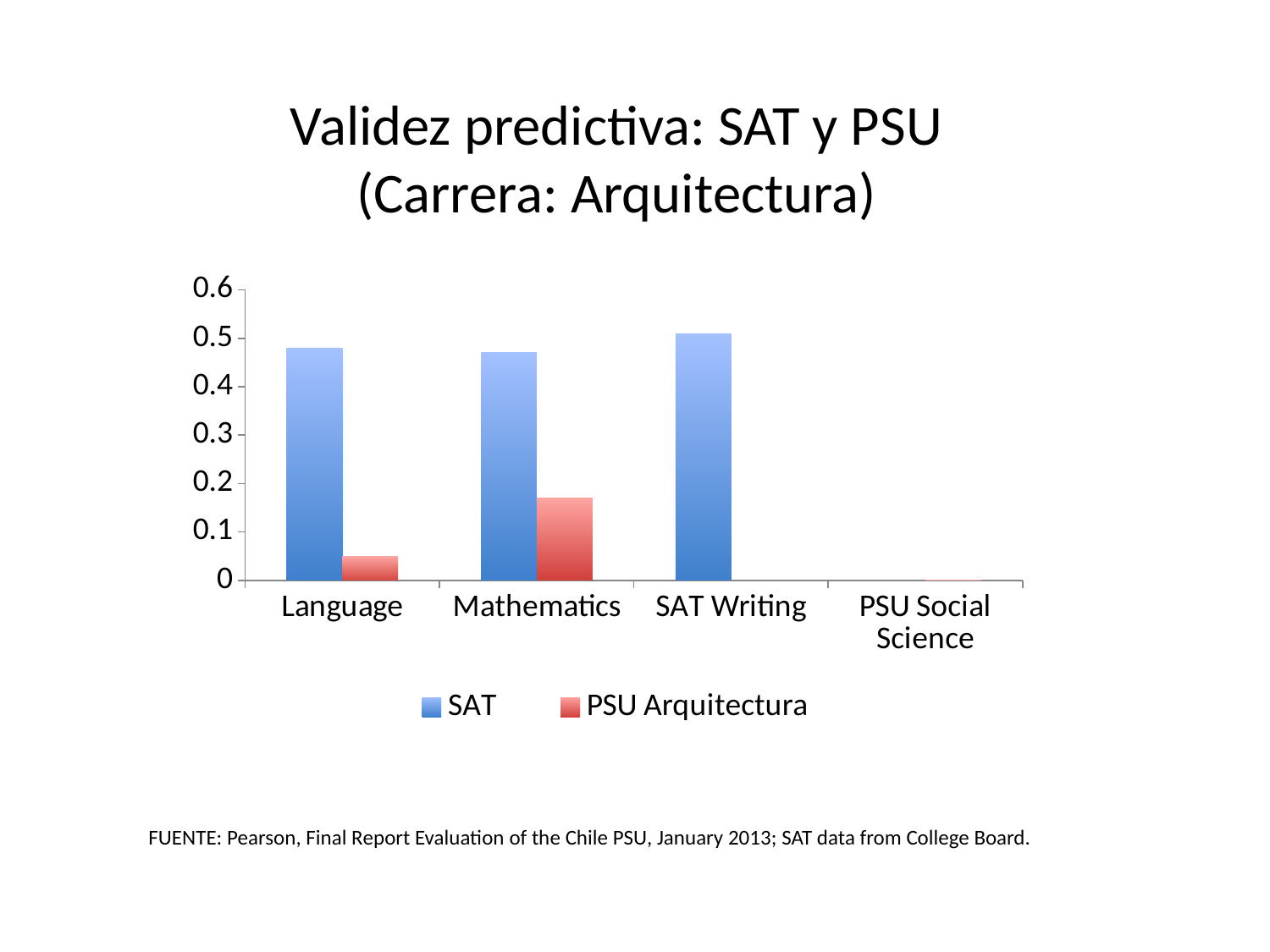
How many categories are shown on the x axis? 4 Is the PSU Arquitectura value for Mathematics greater or less than 0.2? less What colour are the bars for the PSU Arquitectura series? red Is the PSU Arquitectura value for Language greater or less than 0.1? less In Mathematics, which is larger, the SAT value or the PSU Arquitectura value? SAT Is the SAT value for Language greater or less than 0.4? greater What is the title of the chart on the slide? Validez predictiva: SAT y PSU (Carrera: Arquitectura) Which category has the highest SAT value? SAT Writing What kind of chart is shown on the slide? bar chart Which category has the lowest PSU Arquitectura value among those with a visible bar? Language How many series does the legend list? 2